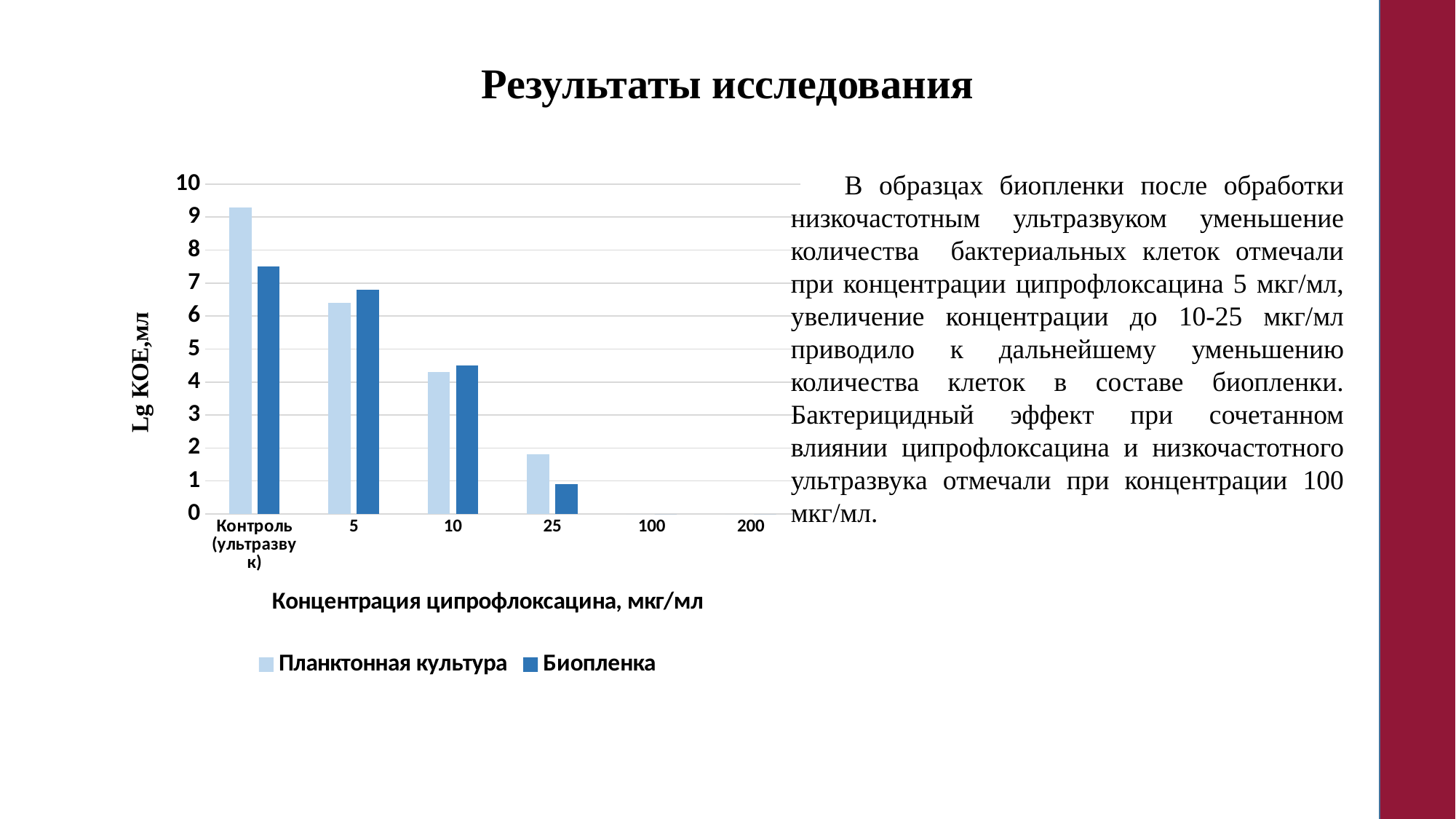
What kind of chart is shown on the slide? bar chart Which category has the highest value for Планктонная культура? Контроль (ультразвук) Which category has the highest value for Биопленка? Контроль (ультразвук) Do the values for Биопленка rise or fall as the concentration increases along the x axis? fall At Контроль (ультразвук), which series has the larger value, Планктонная культура or Биопленка? Планктонная культура How many categories are shown on the x axis? 6 How many series does the legend list? 2 Is the value for Биопленка at Контроль (ультразвук) greater or less than 7? greater At 25, which series has the larger value, Планктонная культура or Биопленка? Планктонная культура Is the value for Планктонная культура at 10 greater or less than 4? greater Is the value for Биопленка at 25 greater or less than 2? less